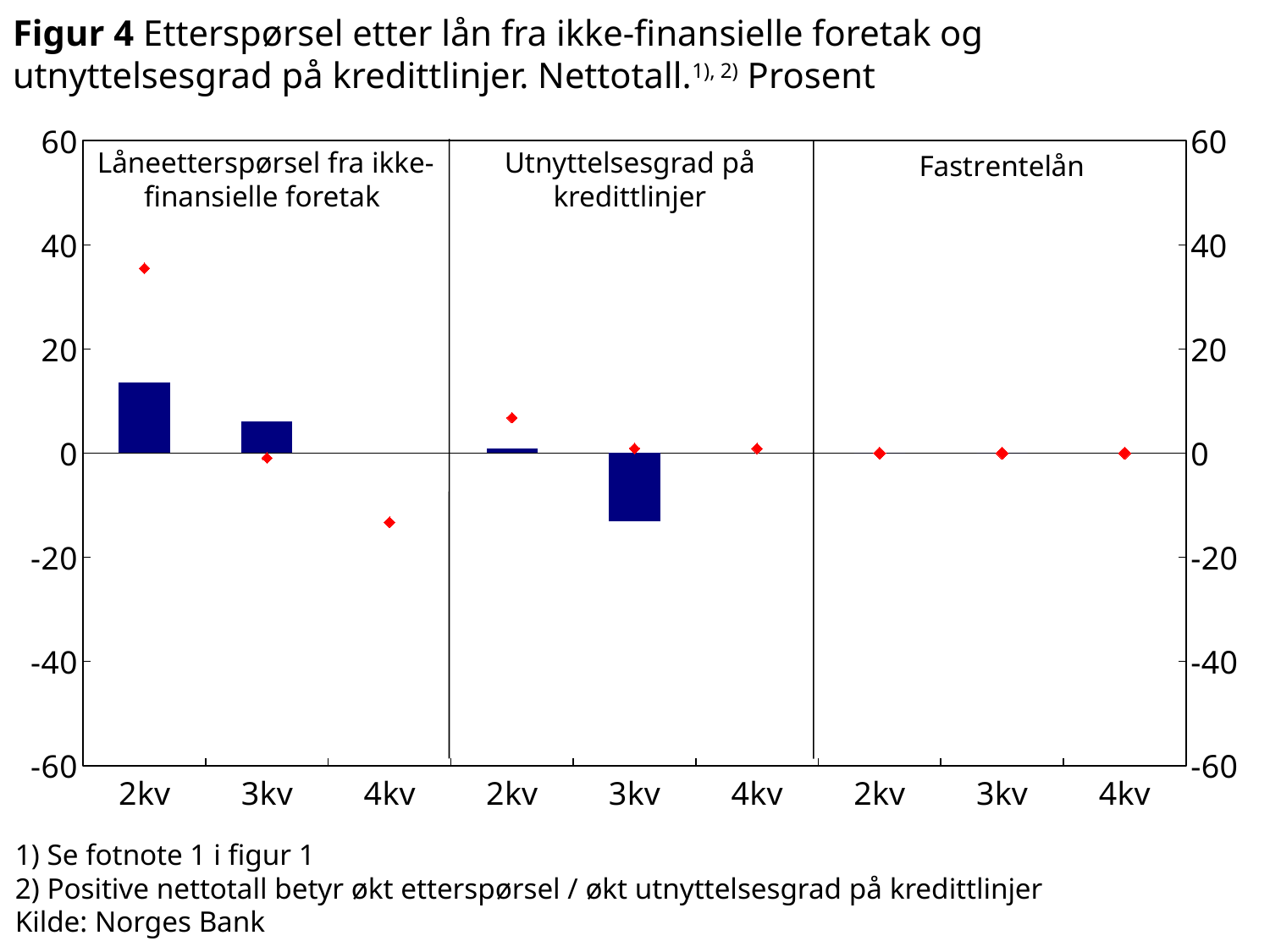
In the panel 'Låneetterspørsel fra ikke-finansielle foretak', is the bar for 2kv greater or less than 20? less In the panel 'Låneetterspørsel fra ikke-finansielle foretak', which quarter has the highest bar? 2kv In the panel 'Utnyttelsesgrad på kredittlinjer', which quarter has the lowest bar? 3kv In the panel 'Låneetterspørsel fra ikke-finansielle foretak', which bar is larger, 2kv or 3kv? 2kv In the panel 'Utnyttelsesgrad på kredittlinjer', is the bar for 3kv greater or less than 0? less What is the highest value shown on the vertical axis? 60 In the panel 'Låneetterspørsel fra ikke-finansielle foretak', do the bars rise or fall from 2kv to 3kv? fall In the panel 'Låneetterspørsel fra ikke-finansielle foretak', is the red diamond for 2kv greater or less than 20? greater What are the names of the three panels in the chart? Låneetterspørsel fra ikke-finansielle foretak, Utnyttelsesgrad på kredittlinjer, Fastrentelån How many panels (sections) does the chart have? 3 What kind of chart is shown on the slide? combination bar and line chart (bars with diamond markers)